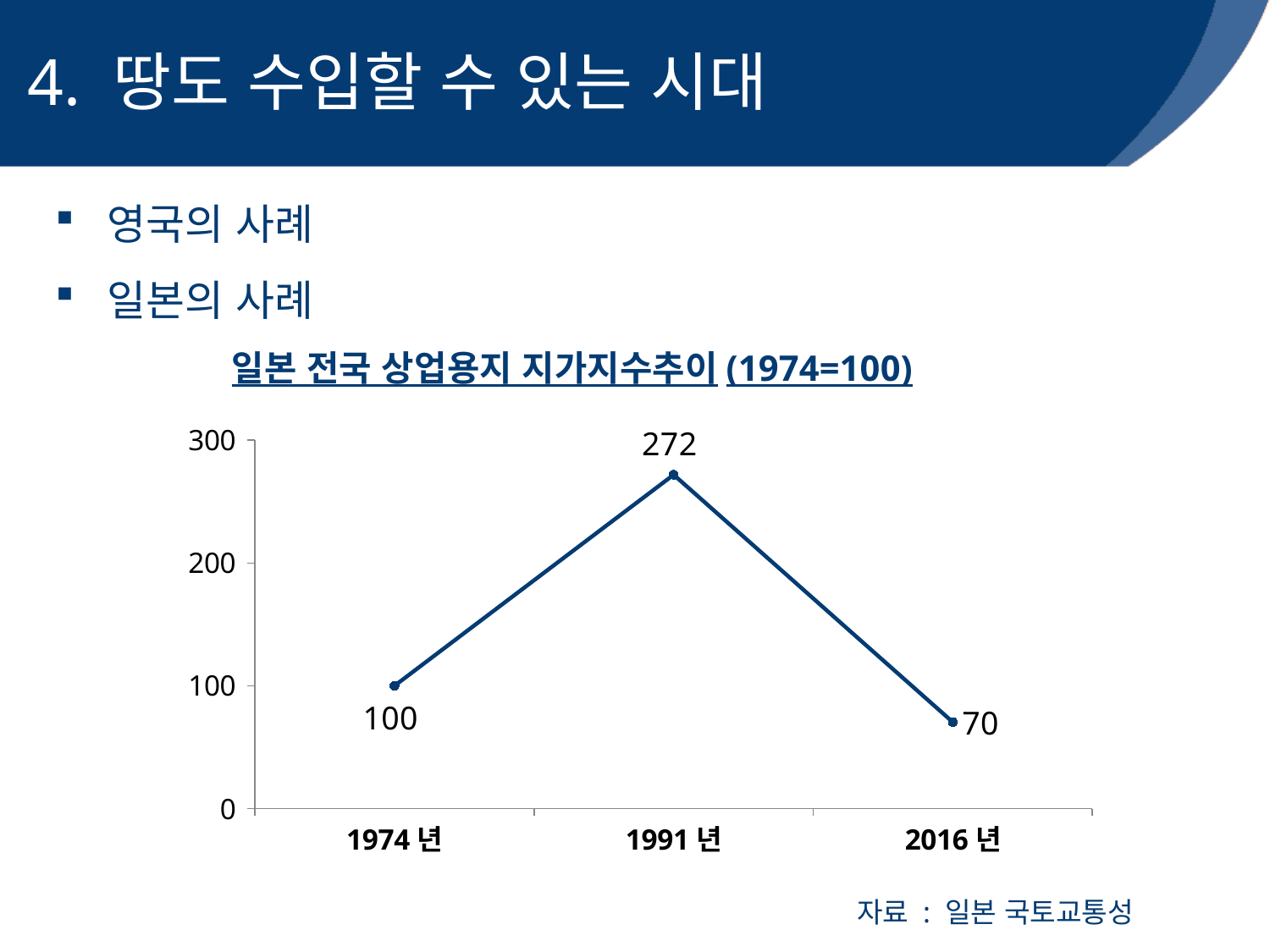
Which year has the lowest value? 2016 년 What kind of chart is shown on the slide? line chart What is the value for 1991 년? 272 Which is larger, the value for 1974 년 or the value for 2016 년? 1974 년 Does the value rise or fall from 1991 년 to 2016 년? fall What is the difference between the values for 1991 년 and 2016 년? 202 What is the title of the chart? 일본 전국 상업용지 지가지수추이 (1974=100) What is the value for 2016 년? 70 What is the value for 1974 년? 100 How many data points are plotted on the chart? 3 Which year has the highest value? 1991 년 What is the difference between the values for 1991 년 and 1974 년? 172